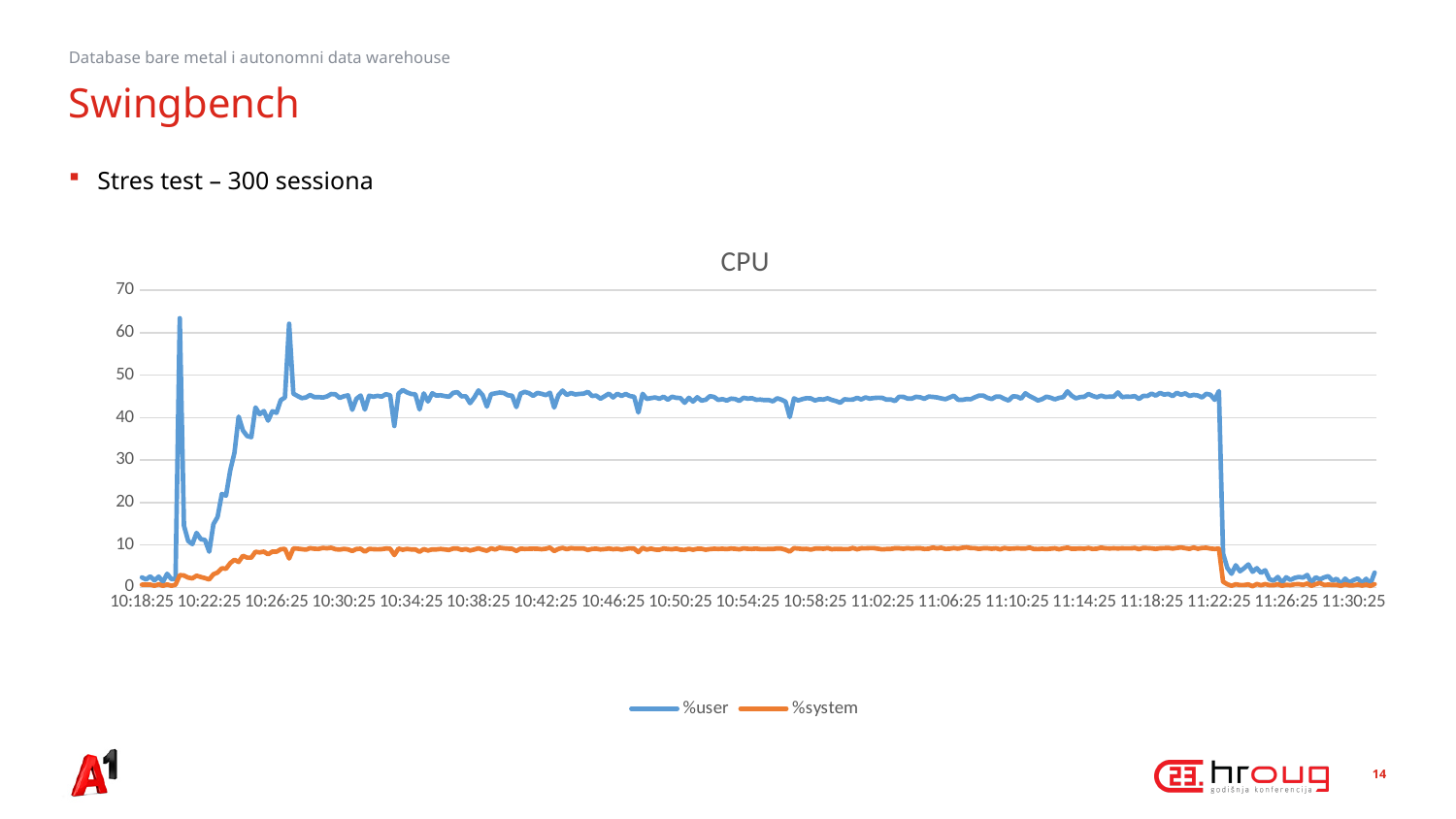
How many time labels are shown on the x axis of the CPU chart? 19 Does the %user series rise or fall between 10:22:25 and 10:26:25? rise Is the value of %system at 11:02:25 greater or less than 20? less How many series does the legend of the CPU chart list? 2 Is the highest peak of %user greater or less than 60? greater What kind of chart is shown on the slide? line chart At 10:50:25, which series has the larger value, %user or %system? %user Which series in the CPU chart is drawn in orange? %system Which series reaches the higher values in the CPU chart, %user or %system? %user Is the value of %user at 11:30:25 greater or less than 10? less What is the title of the chart? CPU